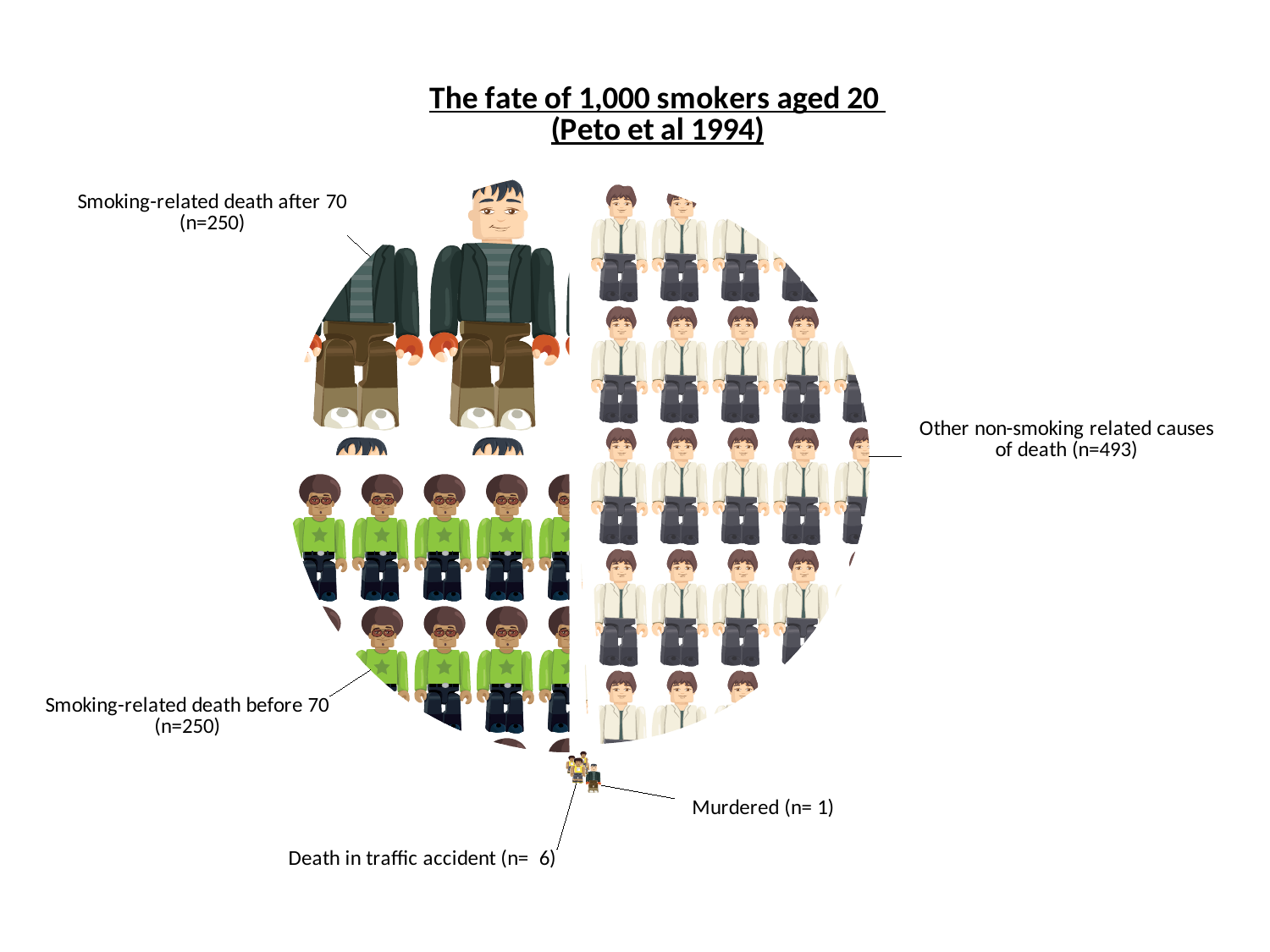
What is the value (n) for 'Death in traffic accident'? 6 What is the difference between 'Other non-smoking related causes of death' and 'Smoking-related death after 70'? 243 What is the value (n) for 'Smoking-related death before 70'? 250 What kind of chart is shown on the slide? pie chart What is the title of the chart? The fate of 1,000 smokers aged 20 (Peto et al 1994) What share of the 1,000 smokers does 'Smoking-related death after 70' represent? 25% Which category has the largest share of the pie? Other non-smoking related causes of death What is the value (n) for 'Other non-smoking related causes of death'? 493 Which is larger: 'Death in traffic accident' or 'Murdered'? Death in traffic accident What is the value (n) for 'Murdered'? 1 Which category has the smallest share of the pie? Murdered How many categories does the pie chart show? 5